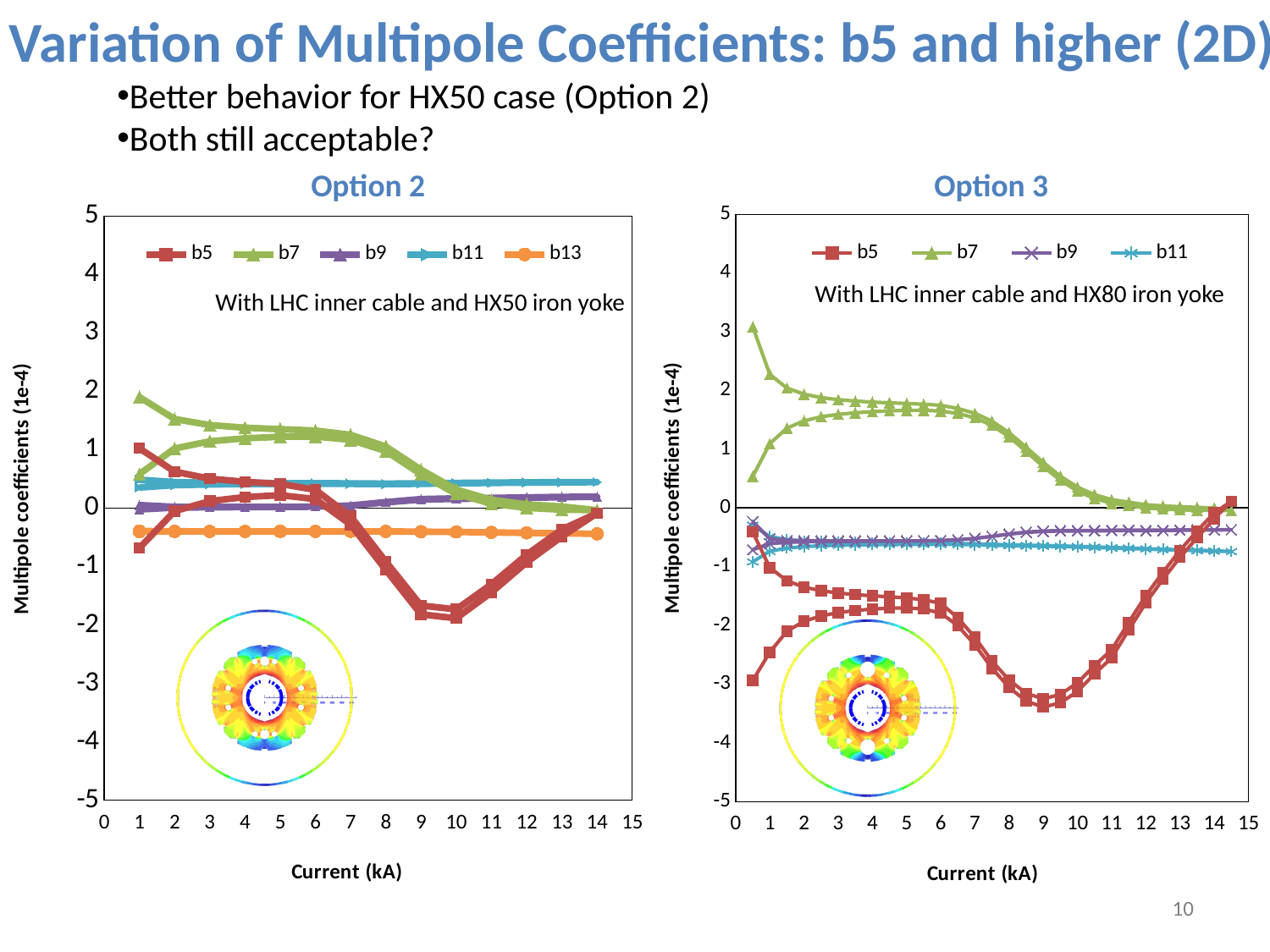
How many series does the legend of the Option 3 chart list? 4 In the Option 3 chart, which series has the highest value at 1 kA? b7 In the Option 2 chart, which is larger at 1 kA, b7 or b5? b7 How many series does the legend of the Option 2 chart list? 5 What is the x-axis label of the Option 3 chart? Current (kA) What kind of chart is the Option 2 chart? line chart In the Option 3 chart, is the highest value of b7 greater or less than 2? greater In the Option 2 chart, is the value of b5 at 10 kA greater or less than -1? less In the Option 3 chart, which series has the lowest value at 9 kA? b5 In the Option 2 chart, is the value of b13 greater or less than 0? less Which series appears in the legend of the Option 2 chart but not in the legend of the Option 3 chart? b13